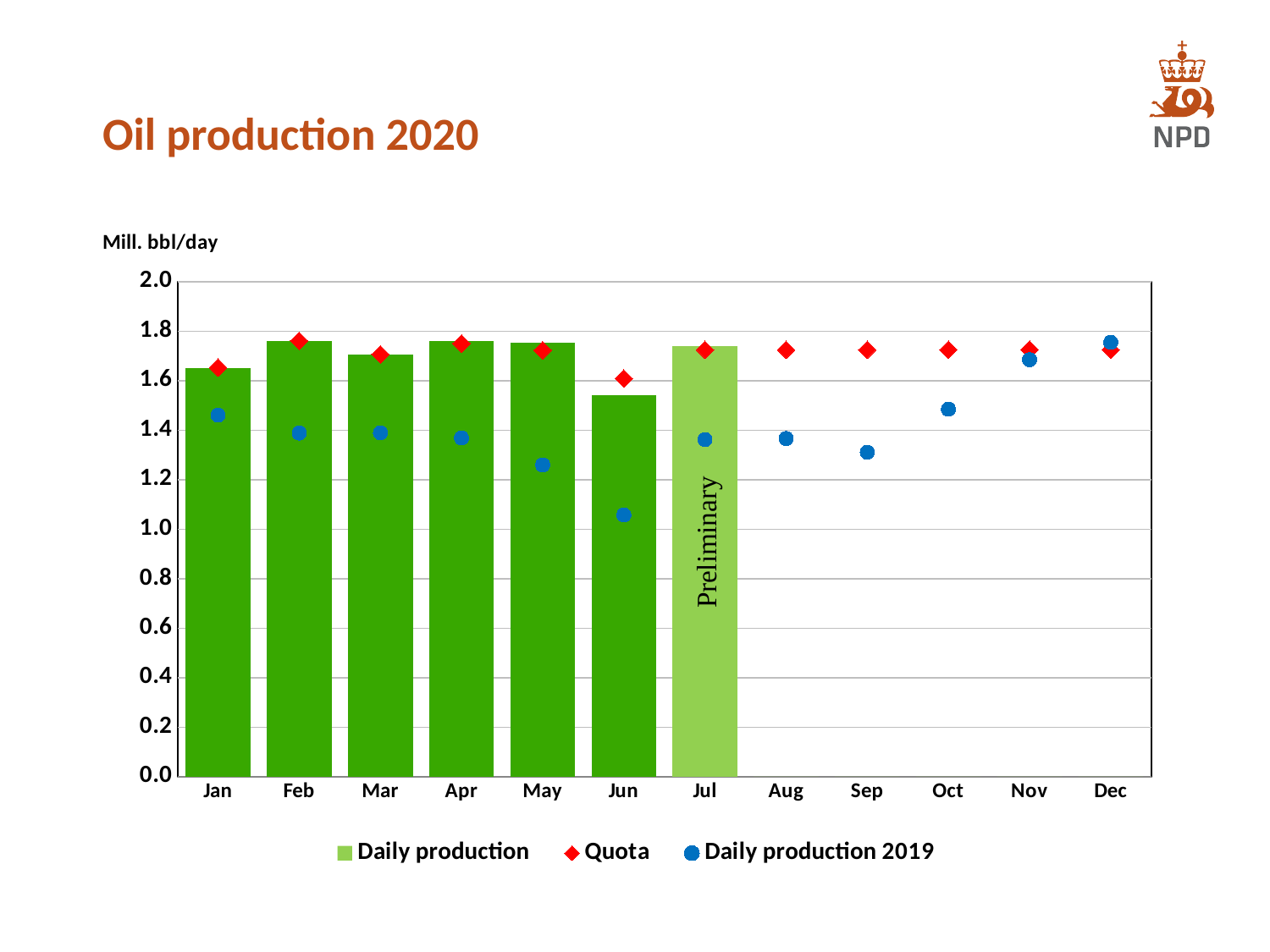
Is the Daily production 2019 value for Sep greater or less than 1.4? less How many months have a Daily production bar? 7 In Jun, which is larger: the Daily production bar or the Quota? Quota Which month has the lowest Daily production bar? Jun Which month has the lowest Quota value? Jun What kind of chart is shown on the slide? bar chart Which month's bar is labelled 'Preliminary'? Jul Which month has the lowest Daily production 2019 value? Jun Is the Daily production bar for Jun greater or less than 1.6? less How many series does the legend list? 3 Which month has the highest Daily production 2019 value? Dec How many months are shown on the x axis? 12